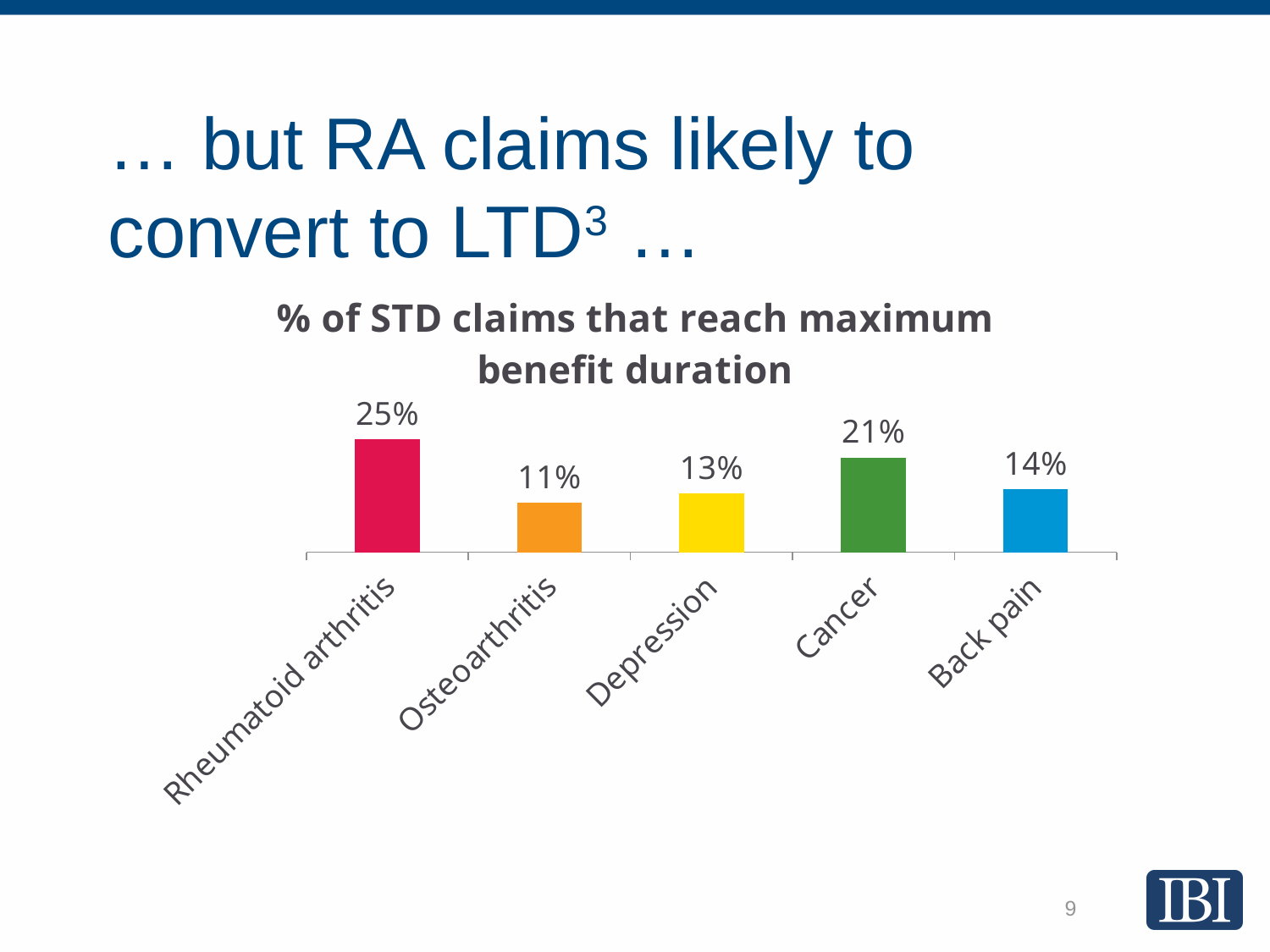
What is the difference between the values for Cancer and Back pain? 7% What type of chart is shown on the slide? Bar chart What is the value shown for Depression? 13% What percentage of STD claims for Rheumatoid arthritis reach maximum benefit duration? 25% Which condition has the highest percentage of STD claims reaching maximum benefit duration? Rheumatoid arthritis What is the value shown for Back pain? 14% What is the title of the chart? % of STD claims that reach maximum benefit duration How many conditions are shown on the chart? 5 Which has a higher value, Depression or Back pain? Back pain What is the difference between the values for Rheumatoid arthritis and Osteoarthritis? 14% What is the value shown for Cancer? 21% Which condition has the lowest percentage of STD claims reaching maximum benefit duration? Osteoarthritis